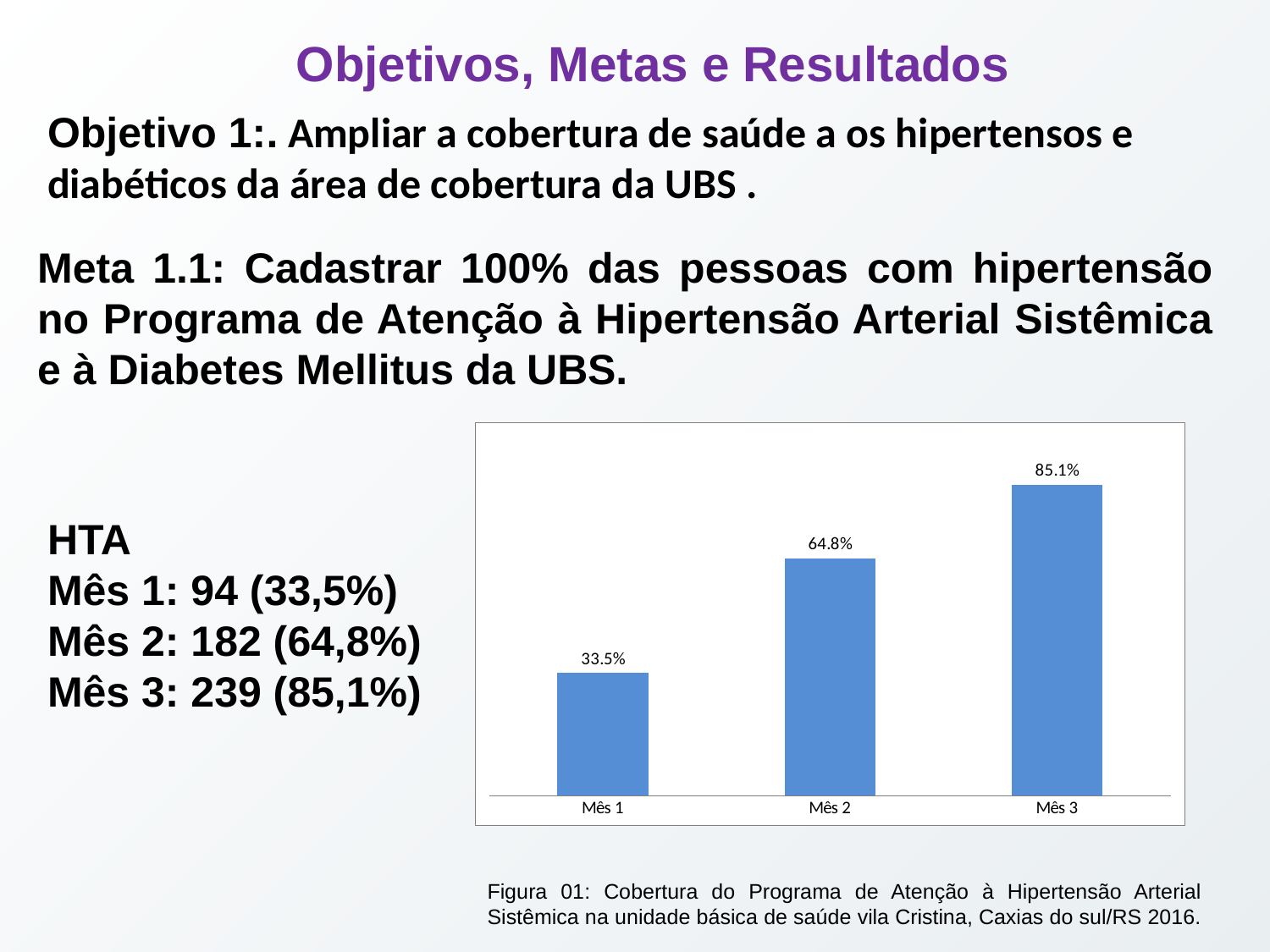
What is the difference between the values for Mês 2 and Mês 1? 31.3% What is the difference between the values for Mês 3 and Mês 1? 51.6% What kind of chart is shown on the slide? Bar chart Do the values rise or fall from Mês 1 to Mês 3? Rise Which is larger, the value for Mês 2 or the value for Mês 3? Mês 3 What is the value for Mês 2 in the chart? 64.8% What colour are the bars in the chart? Blue How many categories are shown on the x axis of the chart? 3 What is the value for Mês 1 in the chart? 33.5% What is the value for Mês 3 in the chart? 85.1% Which month has the highest value in the chart? Mês 3 Which month has the lowest value in the chart? Mês 1